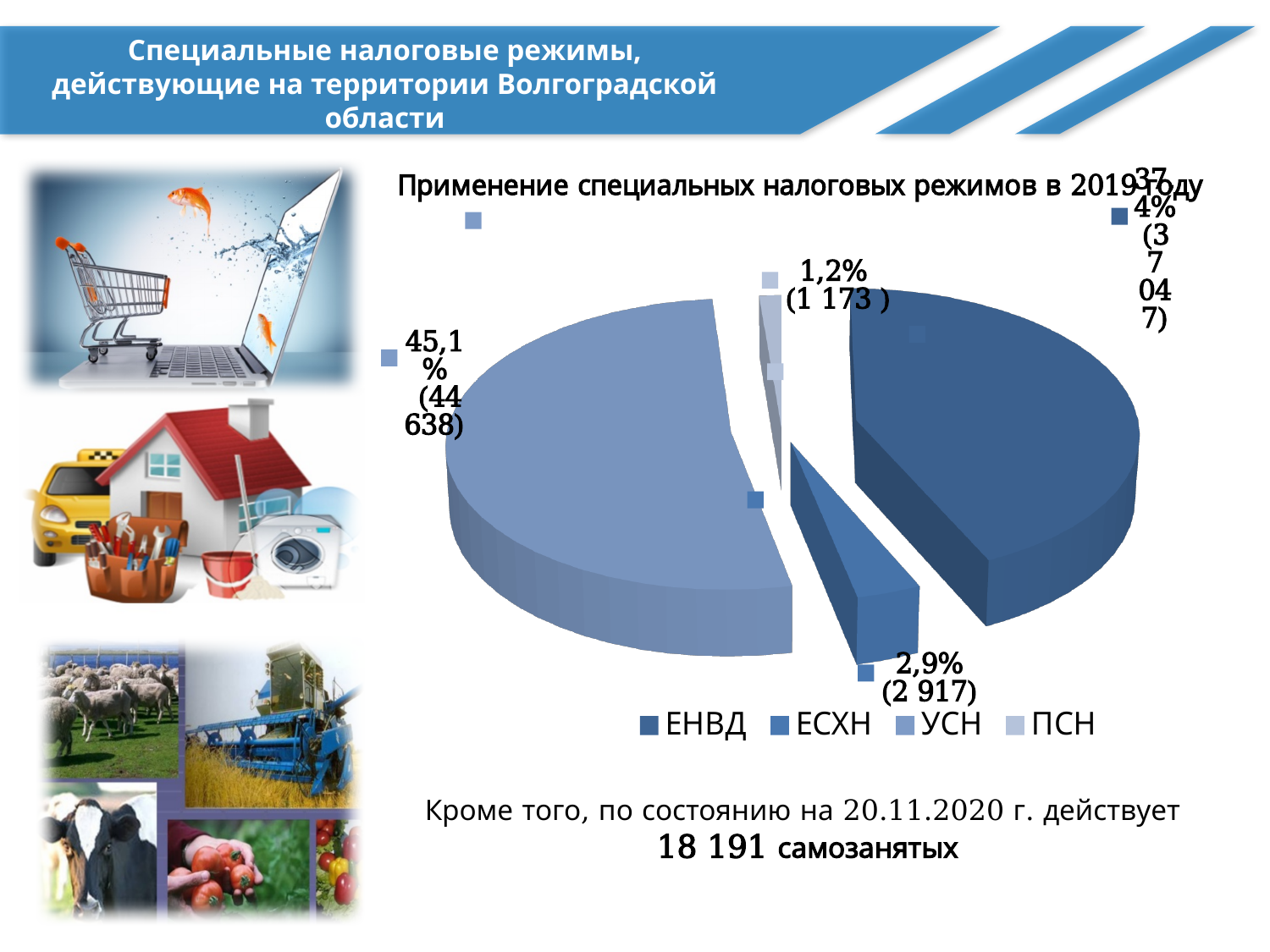
Which tax regime has the largest slice of the pie? УСН What kind of chart is shown on the slide? pie chart What number is shown in parentheses for ПСН? 1 173 How many entries does the chart legend list? 4 What is the title of the chart? Применение специальных налоговых режимов в 2019 году What percentage share does УСН have in the pie chart? 45,1% What is the difference in percentage points between the УСН share and the ЕСХН share? 42,2% Which has the larger share, ЕНВД or ЕСХН? ЕНВД Which tax regime has the smallest slice of the pie? ПСН What number is shown in parentheses for УСН? 44 638 What percentage share does ЕНВД have in the pie chart? 37,4% What percentage share does ЕСХН have in the pie chart? 2,9%